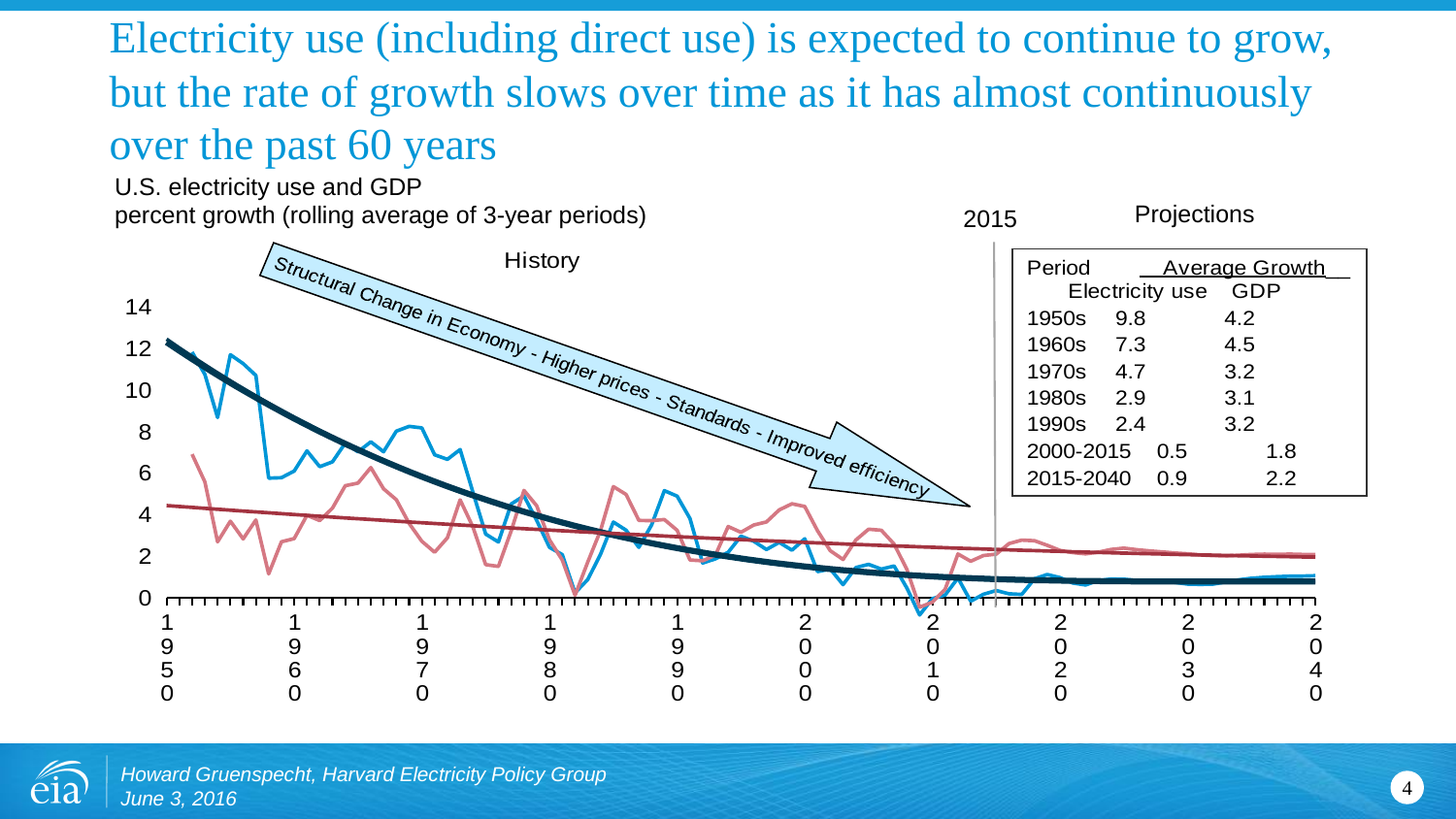
In the 1970s, which was larger according to the table: average electricity use growth or average GDP growth? Electricity use Which period in the table has the highest average growth in electricity use? 1950s How many periods are listed in the Average Growth table? 7 In the 1950s, how much higher was average electricity use growth than average GDP growth according to the table? 5.6 What year marks the boundary between History and Projections on the chart? 2015 According to the table on the chart, what was the average GDP growth in the 1960s? 4.5 What kind of chart is shown on the slide? line chart What average growth in electricity use does the table give for 2015-2040? 0.9 What average GDP growth does the table give for 2000-2015? 1.8 According to the table on the chart, what was the average growth in electricity use in the 1950s? 9.8 Which period in the table has the lowest average growth in electricity use? 2000-2015 Does the blue line generally rise or fall from 1950 to 2015? fall